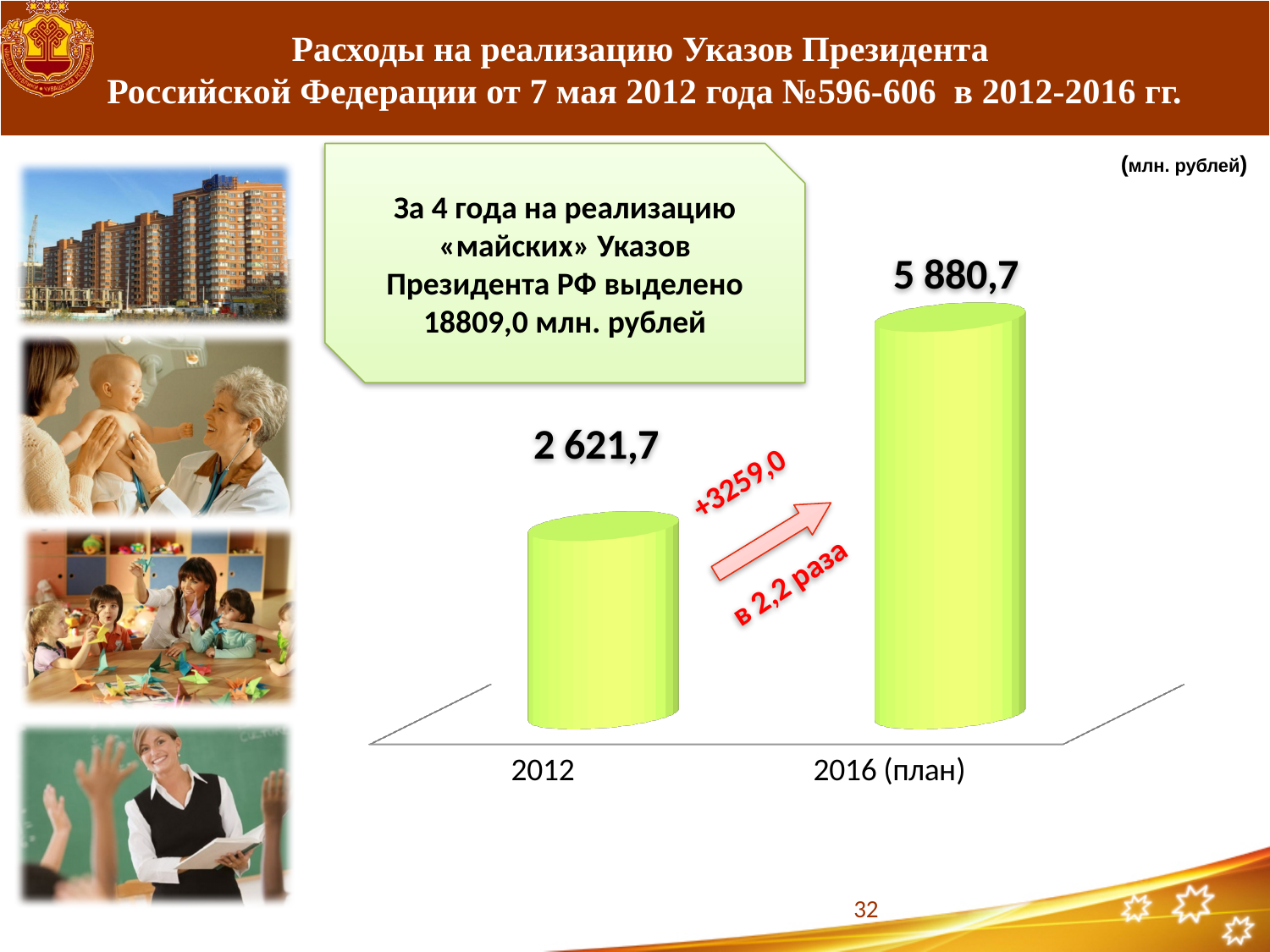
What kind of chart is shown on the slide? Bar chart In what units are the chart values given? млн. рублей What is the value for 2012? 2 621,7 What is the value for 2016 (план)? 5 880,7 Do the values rise or fall from 2012 to 2016 (план)? Rise By what factor does the chart say the value increased from 2012 to 2016 (план)? в 2,2 раза How many categories are shown on the chart? 2 Which is larger, the value for 2012 or the value for 2016 (план)? 2016 (план) Which category has the lowest value? 2012 What is the difference between the values for 2016 (план) and 2012? 3259,0 Which category has the highest value? 2016 (план)